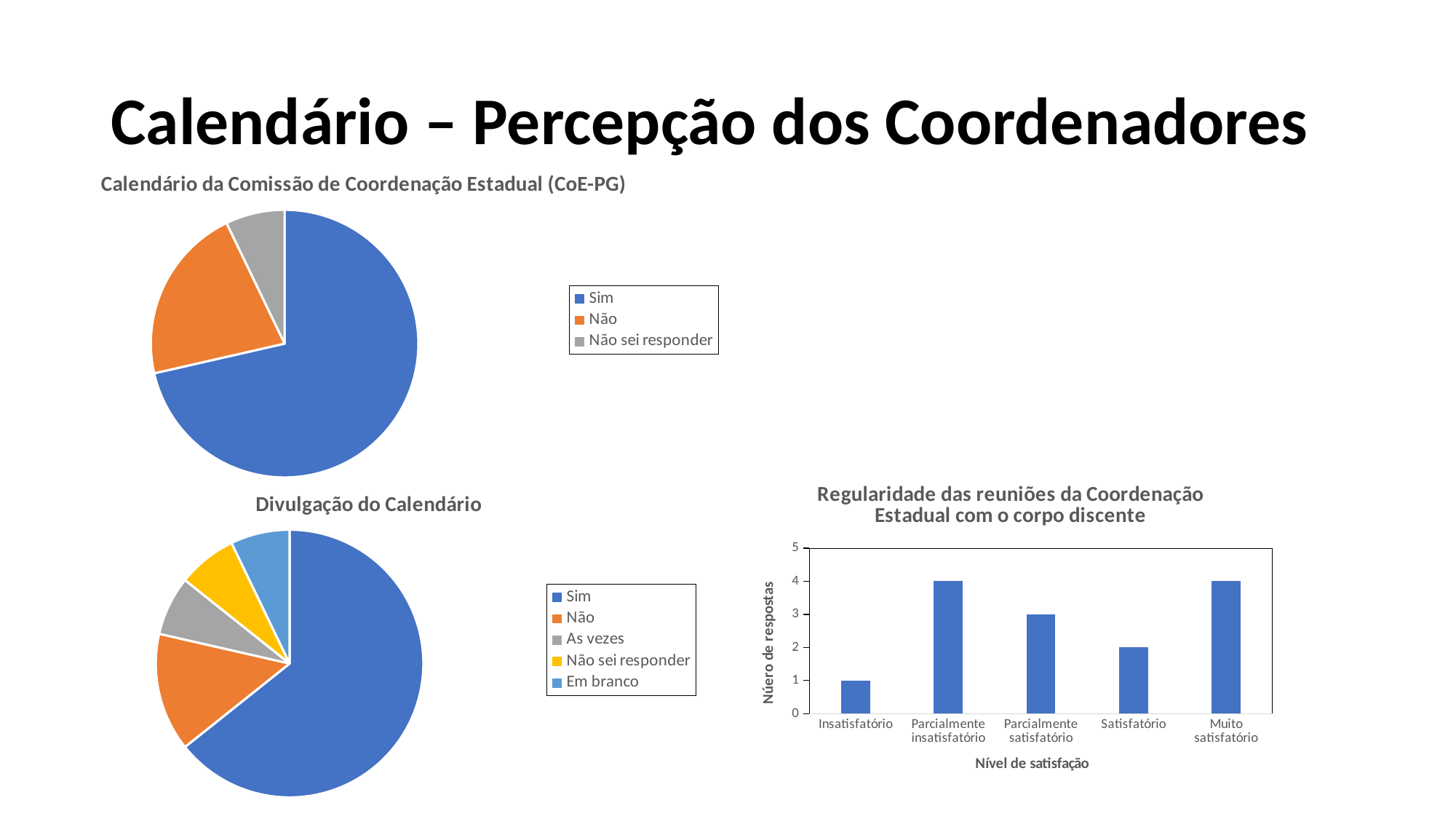
In the chart titled 'Regularidade das reuniões da Coordenação Estadual com o corpo discente', what is the number of responses for 'Parcialmente satisfatório'? 3 In the chart titled 'Regularidade das reuniões da Coordenação Estadual com o corpo discente', what is the number of responses for 'Insatisfatório'? 1 In the pie chart titled 'Calendário da Comissão de Coordenação Estadual (CoE-PG)', what colour is the 'Não' slice? Orange In the chart titled 'Regularidade das reuniões da Coordenação Estadual com o corpo discente', which has more responses: 'Muito satisfatório' or 'Parcialmente satisfatório'? Muito satisfatório In the pie chart titled 'Divulgação do Calendário', which category has the largest slice? Sim In the chart titled 'Regularidade das reuniões da Coordenação Estadual com o corpo discente', what is the difference between the number of responses for 'Parcialmente insatisfatório' and 'Satisfatório'? 2 How many categories does the legend of the pie chart titled 'Divulgação do Calendário' list? 5 In the pie chart titled 'Calendário da Comissão de Coordenação Estadual (CoE-PG)', which category has the largest slice? Sim In the chart titled 'Regularidade das reuniões da Coordenação Estadual com o corpo discente', what is the number of responses for 'Satisfatório'? 2 In the chart titled 'Regularidade das reuniões da Coordenação Estadual com o corpo discente', how many satisfaction levels are shown on the x axis? 5 In the chart titled 'Regularidade das reuniões da Coordenação Estadual com o corpo discente', which satisfaction level has the lowest number of responses? Insatisfatório What kind of chart is 'Regularidade das reuniões da Coordenação Estadual com o corpo discente'? Bar chart